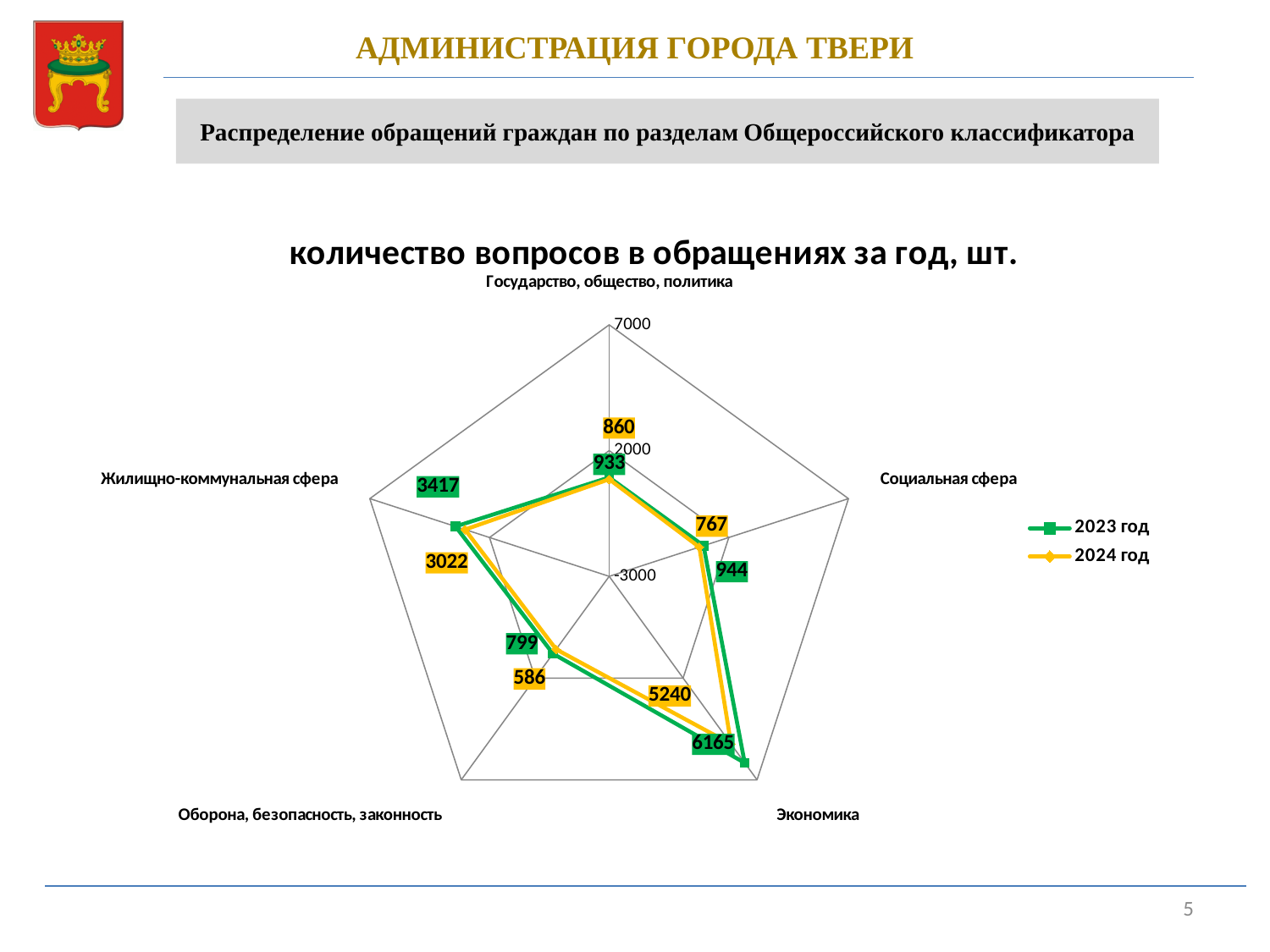
Which category has the lowest value in the 2024 год series? Оборона, безопасность, законность How many categories are plotted on the radar chart? 5 What is the difference between the 2023 год and 2024 год values for Экономика? 925 What kind of chart is shown on the slide? radar chart What is the title of the chart? количество вопросов в обращениях за год, шт. What is the value for Экономика in the 2023 год series? 6165 Which is larger for Социальная сфера: the 2023 год value or the 2024 год value? 2023 год What is the value for Экономика in the 2024 год series? 5240 How many series does the legend list? 2 What is the value for Жилищно-коммунальная сфера in the 2024 год series? 3022 Which category has the highest value in the 2023 год series? Экономика What is the value for Оборона, безопасность, законность in the 2023 год series? 799